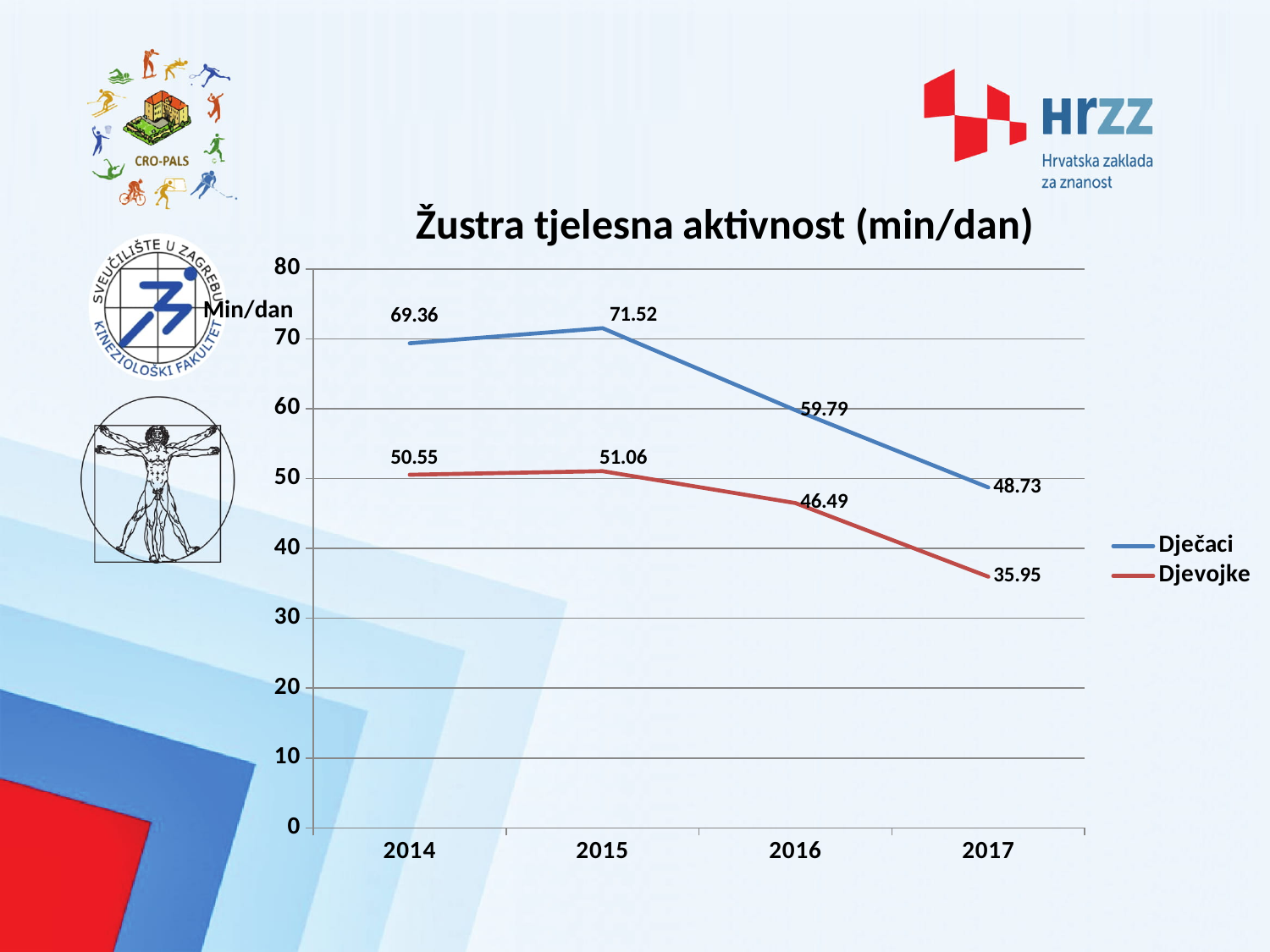
Does the Djevojke series rise or fall from 2015 to 2017? fall What is the value for Dječaci in 2015? 71.52 What kind of chart is shown? line chart Which is larger, the Dječaci value in 2014 or the Dječaci value in 2017? 2014 What is the difference between Dječaci and Djevojke in 2016? 13.3 What is the value for Djevojke in 2014? 50.55 In which year is the Dječaci value highest? 2015 How many series does the legend list? 2 In which year is the Djevojke value lowest? 2017 What is the value for Djevojke in 2017? 35.95 Is the value for Djevojke in 2016 greater or less than 50? less How many years are shown on the x axis? 4